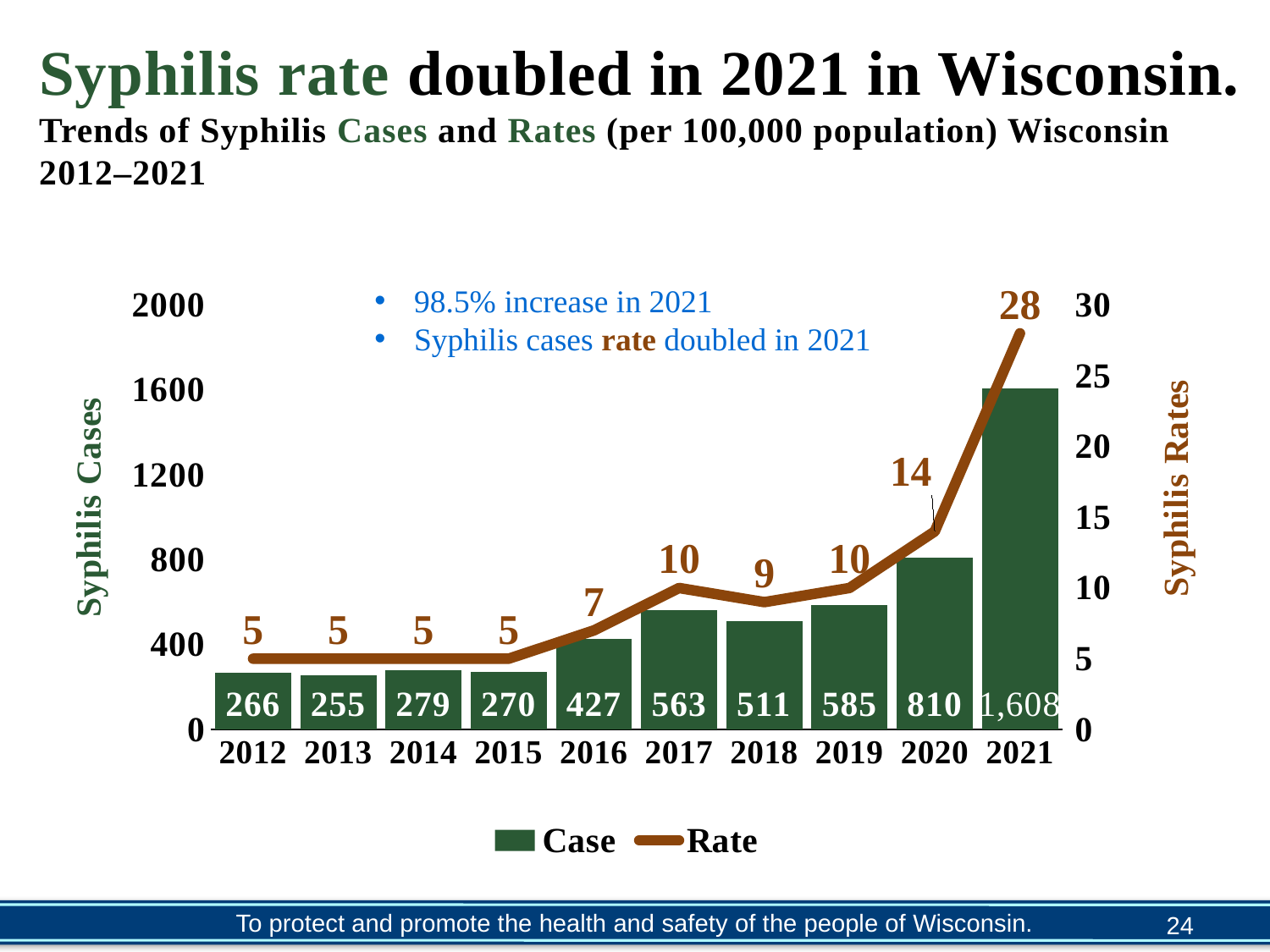
How many years are shown on the x axis? 10 What was the syphilis rate in 2018? 9 Which year had the highest number of syphilis cases? 2021 What is the label of the right-hand vertical axis? Syphilis Rates What kind of chart is used to show the syphilis cases? Bar chart How many syphilis cases were reported in Wisconsin in 2020? 810 How many series does the legend list? 2 What is the overall trend of the syphilis rate from 2015 to 2021? Rising What is the difference in syphilis cases between 2021 and 2020? 798 Which year had the lowest number of syphilis cases? 2013 Which year had more syphilis cases, 2017 or 2018? 2017 What was the syphilis rate in 2021? 28